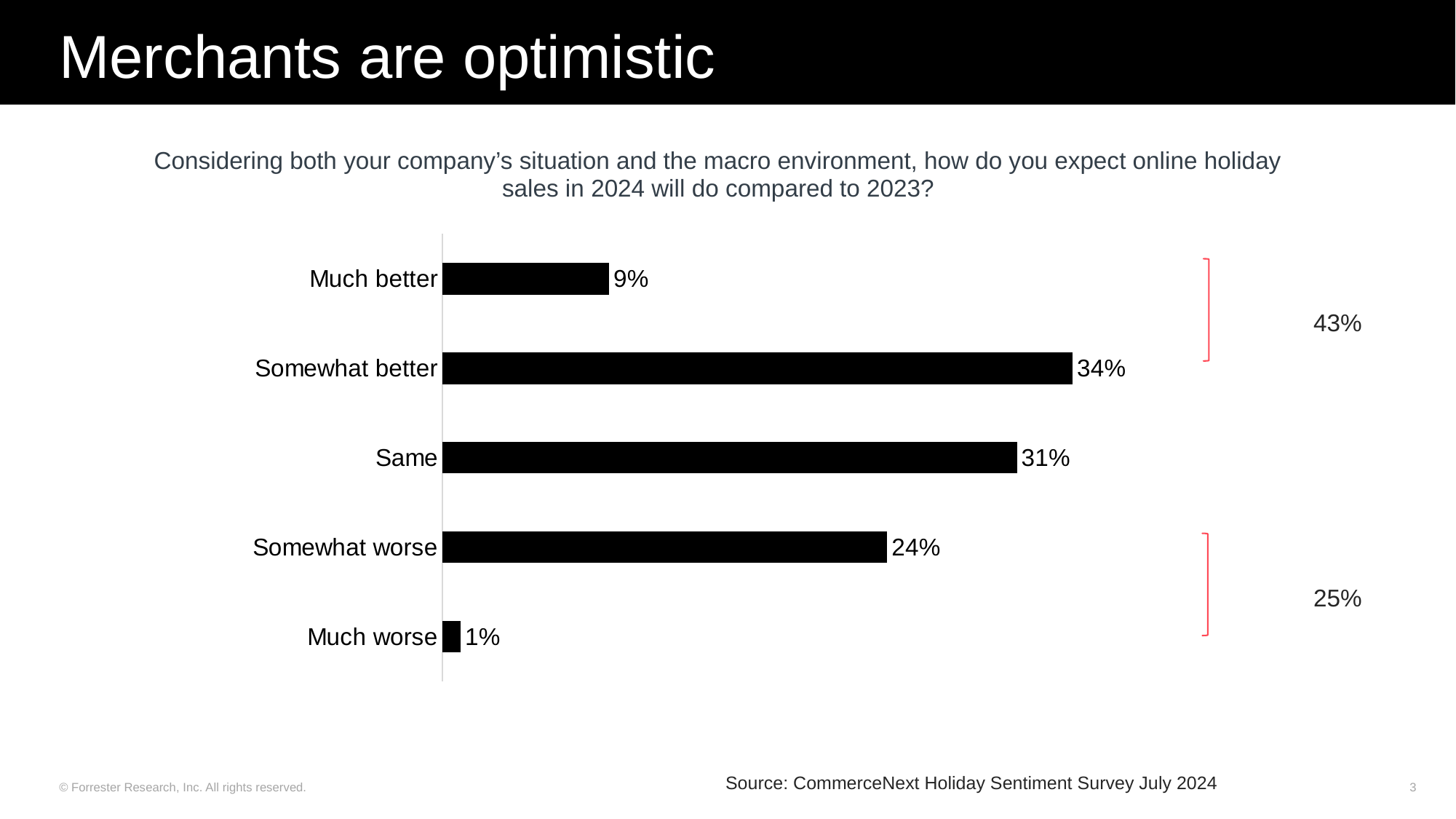
What is the source cited for the chart data? CommerceNext Holiday Sentiment Survey July 2024 How many response categories are shown in the chart? 5 Which response category has the lowest value? Much worse What is the combined total of 'Much better' and 'Somewhat better' as annotated on the slide? 43% What kind of chart is shown on the slide? Bar chart What is the value shown for 'Much worse'? 1% What is the value shown for 'Same'? 31% Which is larger, the value for 'Much better' or the value for 'Somewhat worse'? Somewhat worse Which response category has the highest value? Somewhat better What percentage of respondents expect online holiday sales in 2024 to be 'Somewhat better' than 2023? 34% What is the difference between the 'Somewhat better' and 'Somewhat worse' values? 10% What is the combined total of 'Somewhat worse' and 'Much worse' as annotated on the slide? 25%